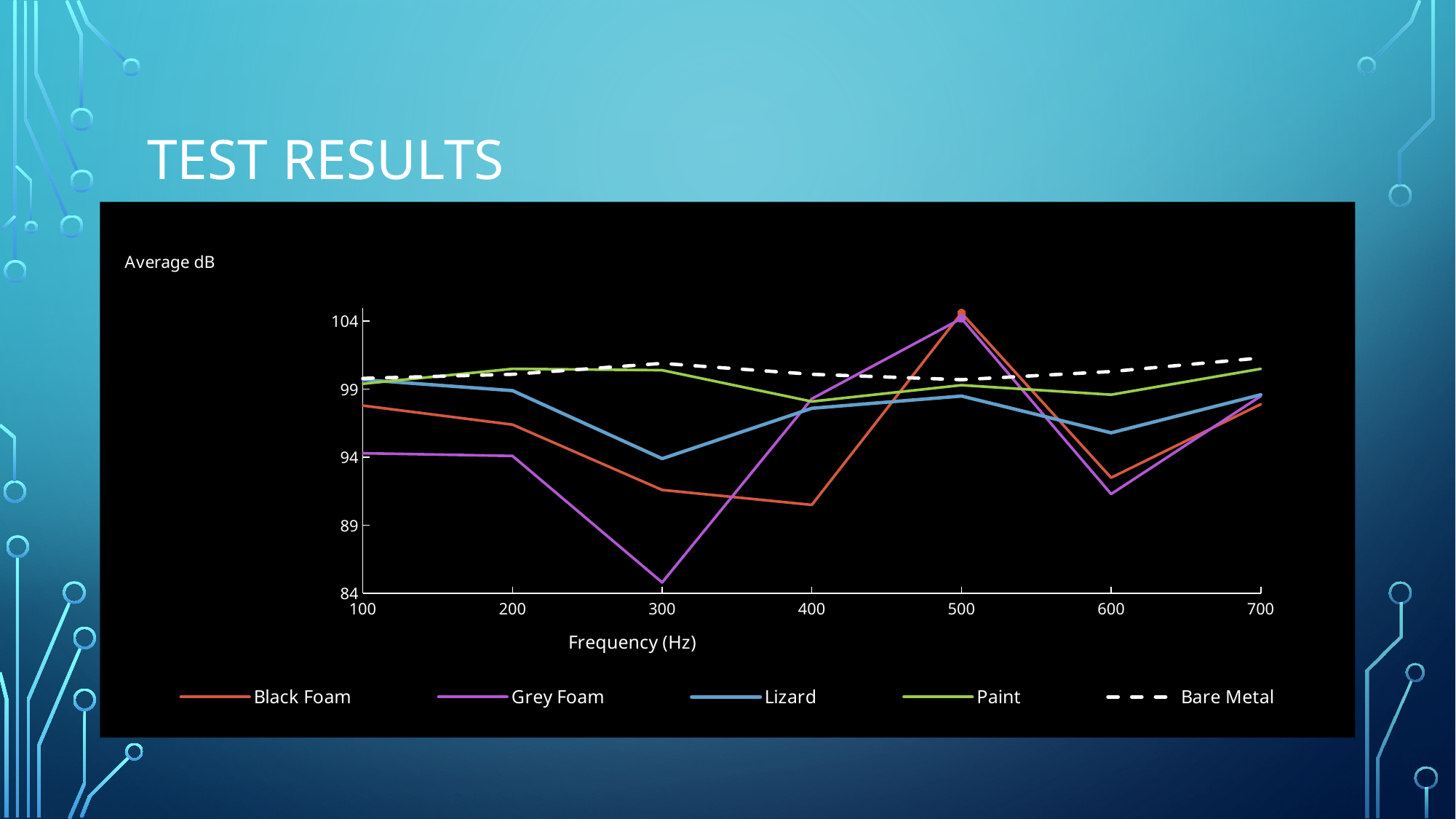
Does the Black Foam line rise or fall from 100 Hz to 400 Hz? fall What kind of chart is shown on the slide? line chart Which series has the highest value at 600 Hz? Bare Metal Which series is drawn with a dashed line? Bare Metal Is the value for Black Foam at 500 Hz greater or less than 99? greater Is the value for Lizard at 600 Hz greater or less than 94? greater At 100 Hz, which is higher: Black Foam or Grey Foam? Black Foam At 300 Hz, which is higher: Lizard or Black Foam? Lizard Which series has the lowest value at 300 Hz? Grey Foam Is the value for Grey Foam at 300 Hz greater or less than 89? less How many frequency points are plotted along the x axis? 7 How many series does the legend list? 5